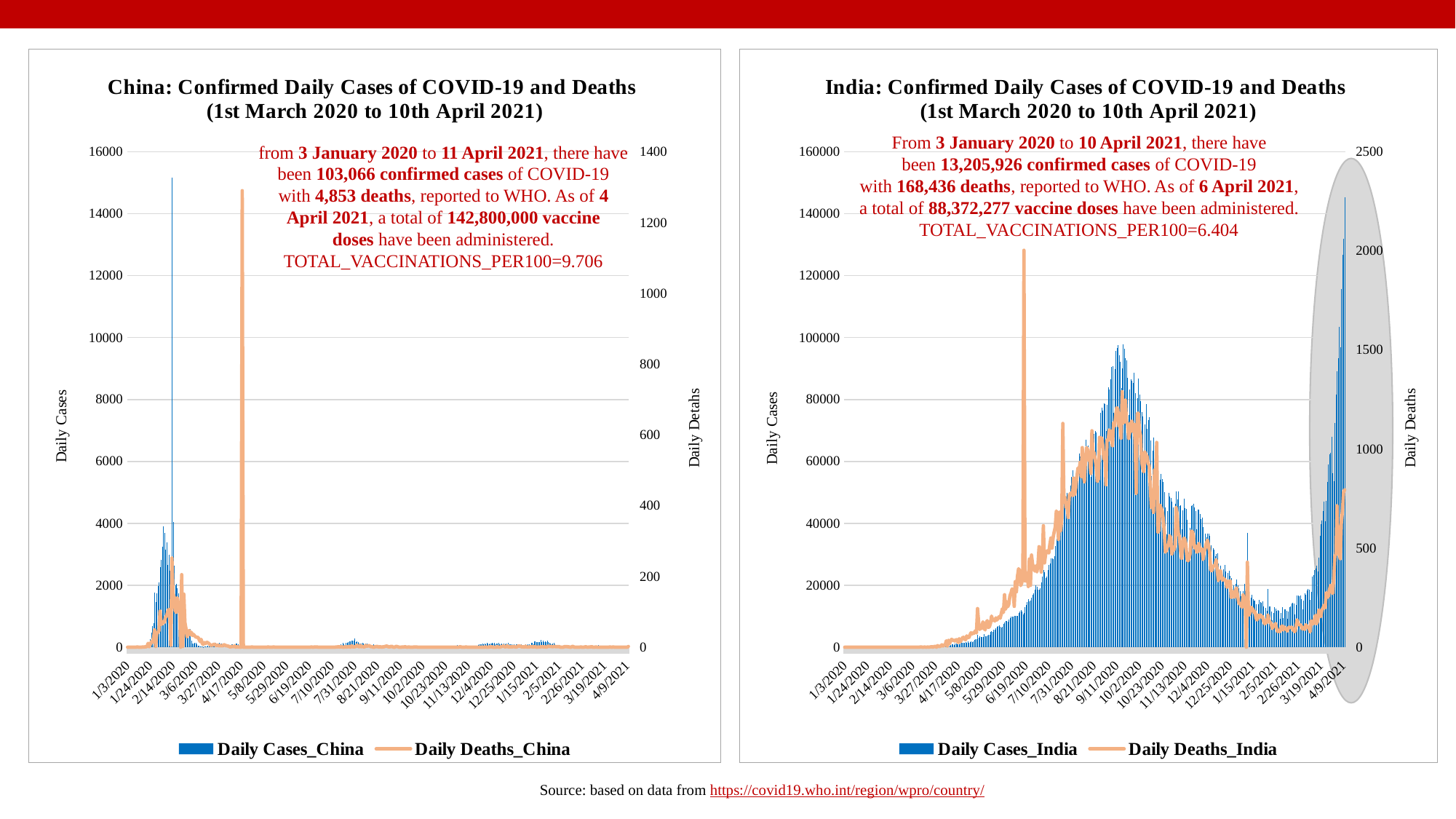
On the China chart, is the peak of the daily deaths line greater or less than 1000 on the right axis? greater On the India chart, is the peak of the daily deaths line greater or less than 1500 on the right axis? greater On the India chart, what is the maximum value shown on the right-hand Daily Deaths axis? 2500 On the India chart, do daily cases rise or fall between 3/27/2020 and 9/11/2020? rise On the India chart, do daily cases rise or fall between 9/11/2020 and 2/5/2021? fall On the India chart, what kind of chart is used to show the daily deaths? Line chart On the China chart, is the highest daily cases bar greater or less than 14000? greater On the China chart, how many series does the legend list? 2 Comparing the two charts, which country has the higher peak in daily cases, China or India? India On the India chart, what are the two series named in the legend? Daily Cases_India and Daily Deaths_India On the China chart, what kind of chart is used to show the daily cases? Bar chart